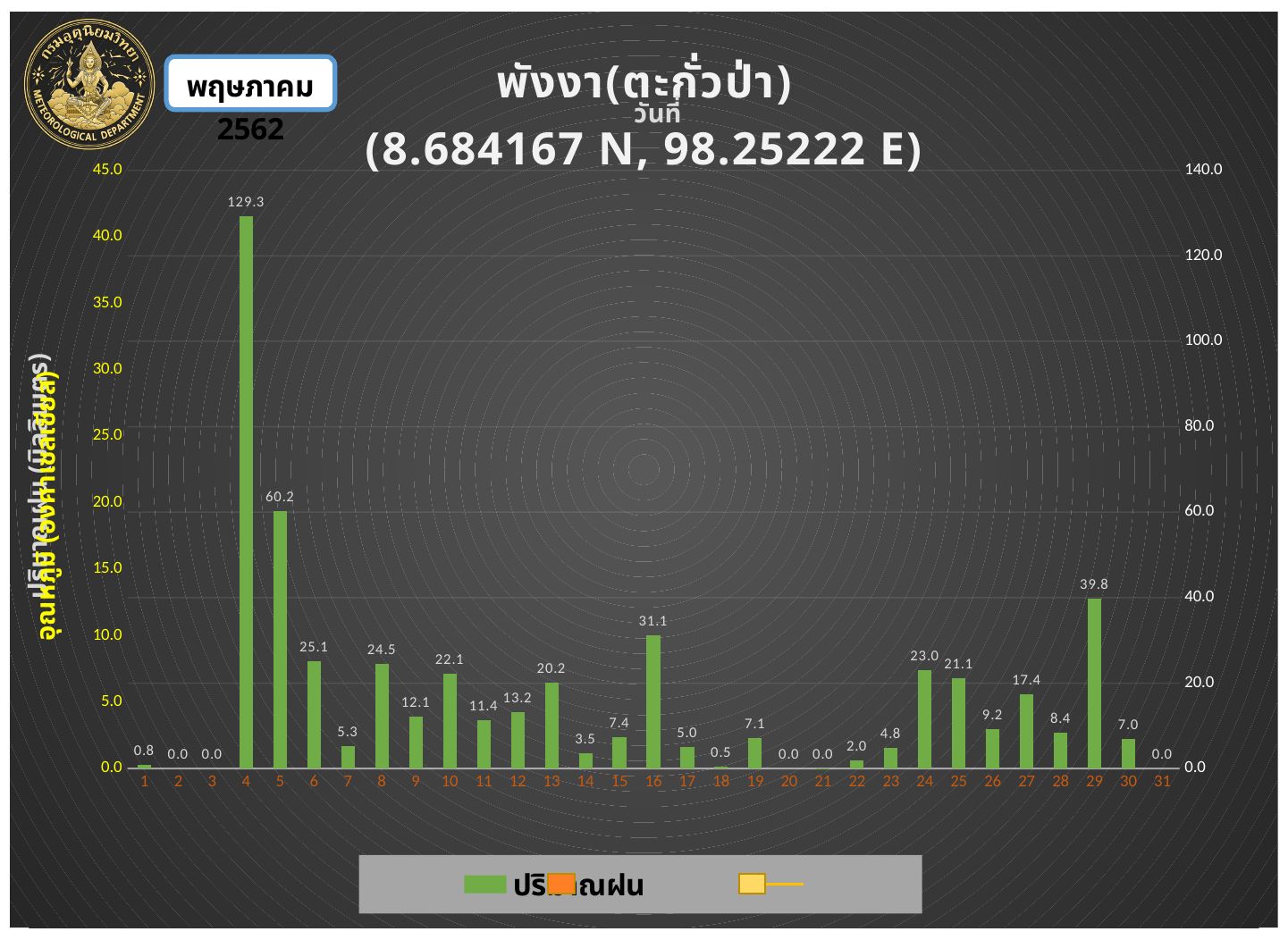
Which day has the highest value? 4 What colour are the bars in the chart? green How many days are shown on the x axis? 31 Which is larger, the value for day 6 or the value for day 8? day 6 What kind of chart is this? bar chart What is the value for day 24? 23.0 What is the difference between the values for day 4 and day 5? 69.1 What is the difference between the values for day 29 and day 16? 8.7 What is the value for day 4? 129.3 What is the value for day 29? 39.8 What is the value for day 16? 31.1 Which is larger, the value for day 13 or the value for day 25? day 25